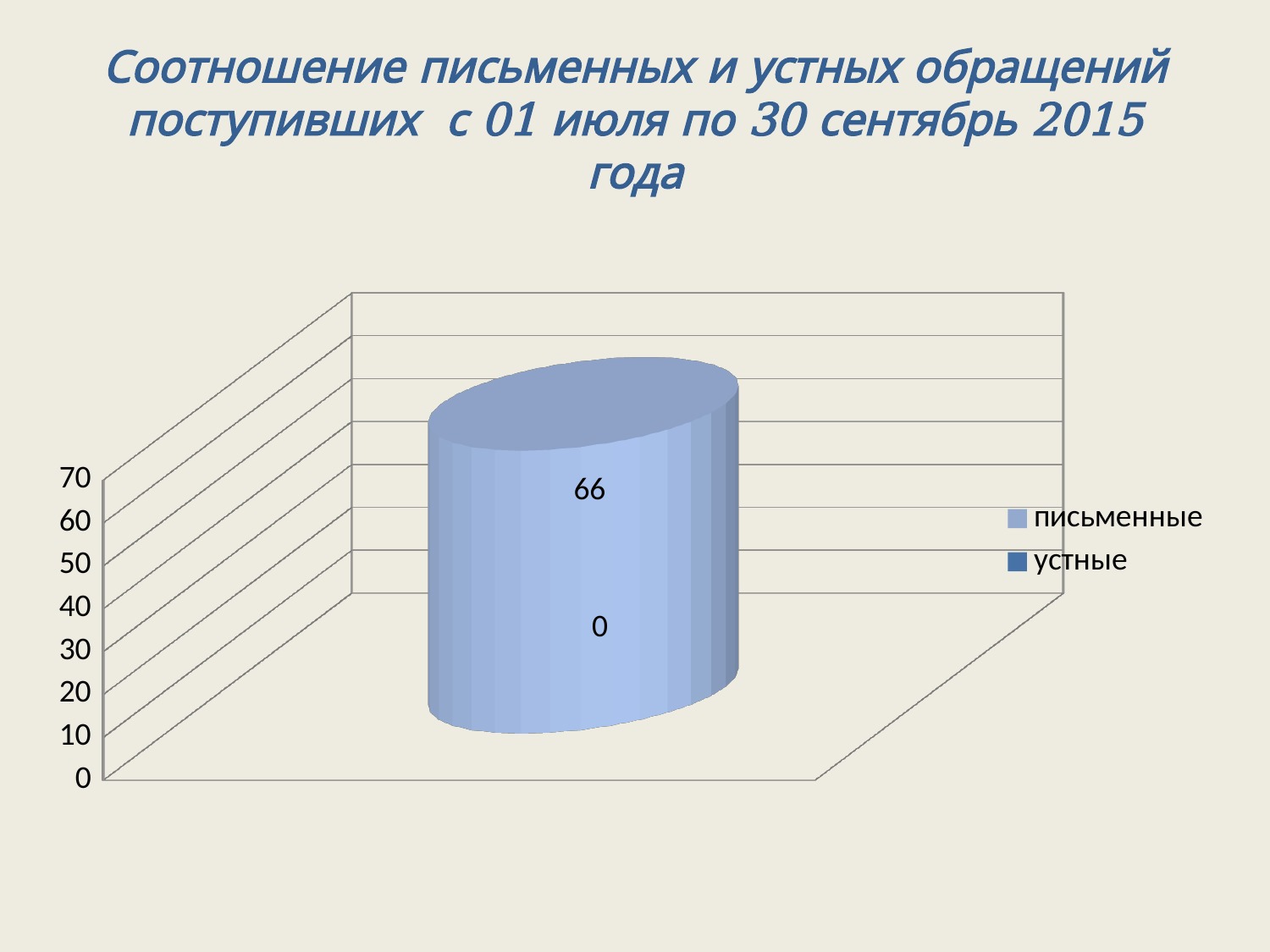
Which series has the lowest value? устные Which series has the highest value? письменные What is the highest value shown on the vertical axis? 70 What kind of chart is shown on the slide? bar chart What is the total of the values for письменные and устные? 66 What are the two legend entries of the chart? письменные, устные What is the difference between the values for письменные and устные? 66 Which series has the higher value, письменные or устные? письменные What is the value for письменные? 66 Is the value for письменные greater or less than 50? greater How many series does the legend list? 2 What is the value for устные? 0